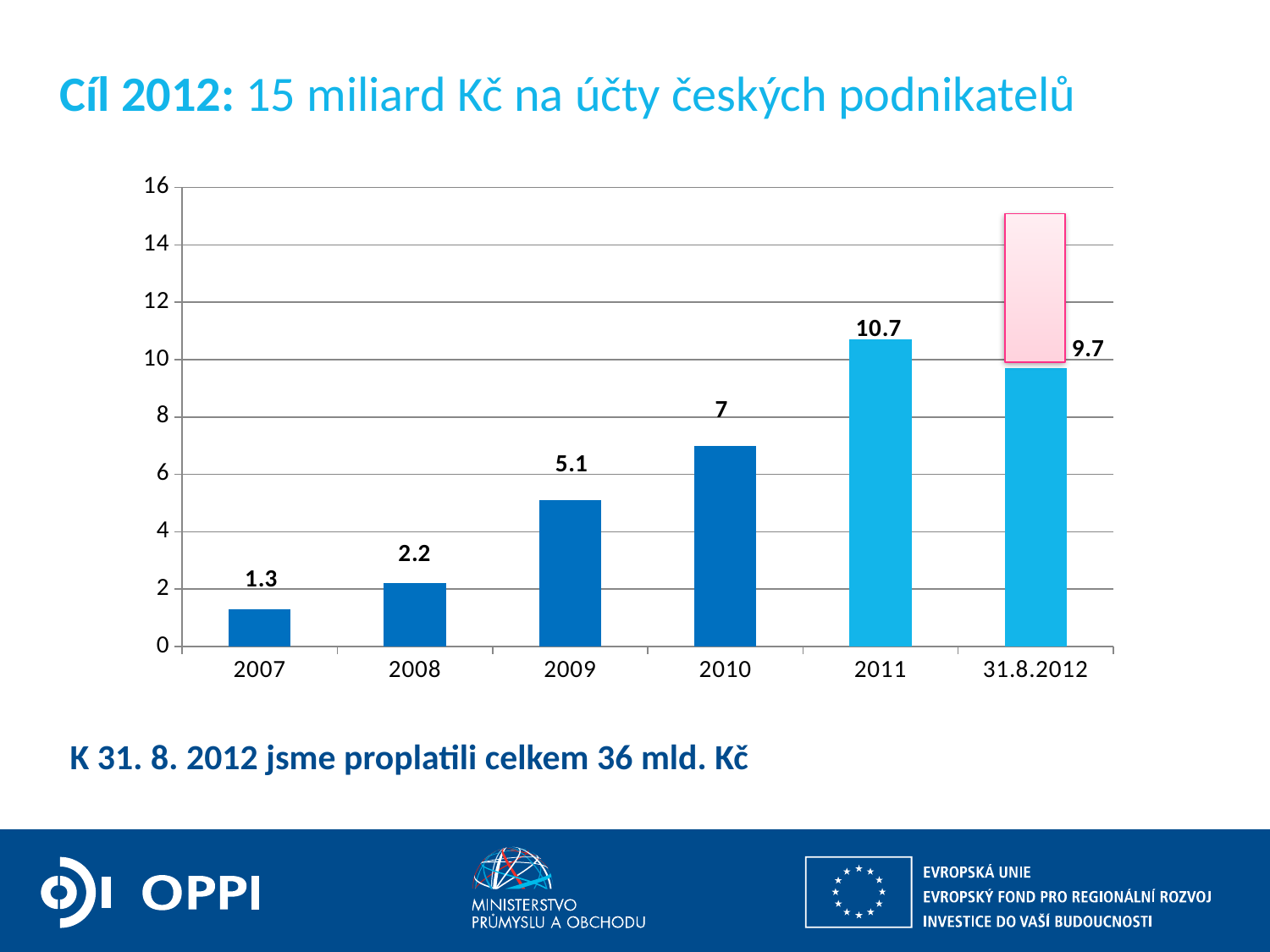
What is the value for 2007? 1.3 How many categories are shown on the x axis? 6 Which is larger, the value for 2008 or the value for 2010? 2010 What is the value for 2009? 5.1 What is the difference between the values for 2010 and 2009? 1.9 Which category has the lowest value? 2007 Which category has the highest value? 2011 What is the difference between the values for 2011 and 31.8.2012? 1 What is the value for 2011? 10.7 What is the value for 31.8.2012? 9.7 Do the values rise or fall from 2007 to 2011? rise What kind of chart is shown on the slide? bar chart